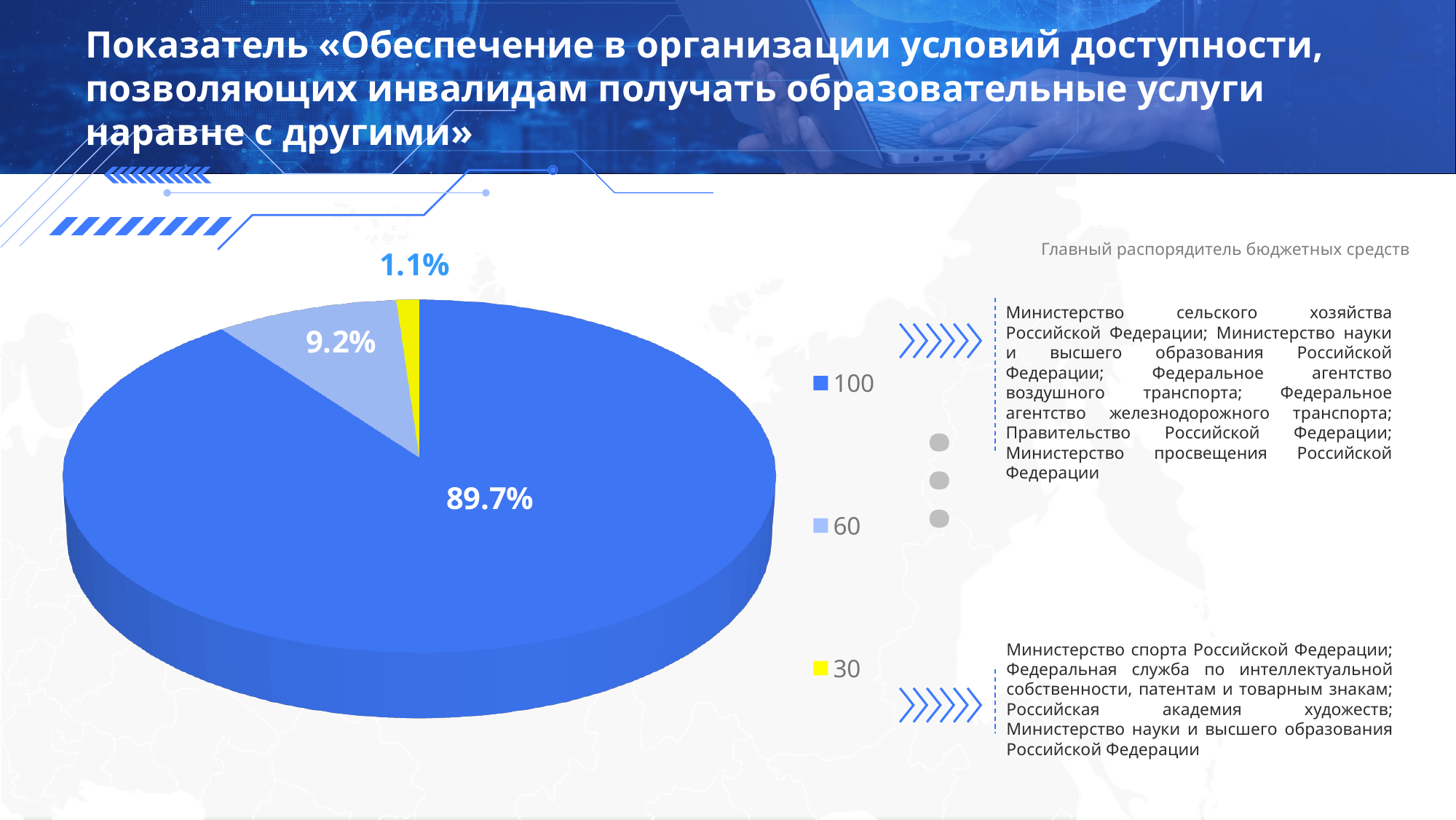
Which category has the largest slice of the pie? 100 What kind of chart is shown on the slide? pie chart Which category has the smallest slice of the pie? 30 What is the combined share of the slices for "60" and "30"? 10.3% How many slices does the pie chart have? 3 How many entries does the legend list? 3 Which slice is larger, the one for "60" or the one for "30"? 60 What colour is the slice for the category "30"? yellow What is the difference in percentage points between the slices for "100" and "60"? 80.5 What share of the pie does the category "60" have? 9.2% What share of the pie does the category "30" have? 1.1% What share of the pie does the category "100" have? 89.7%